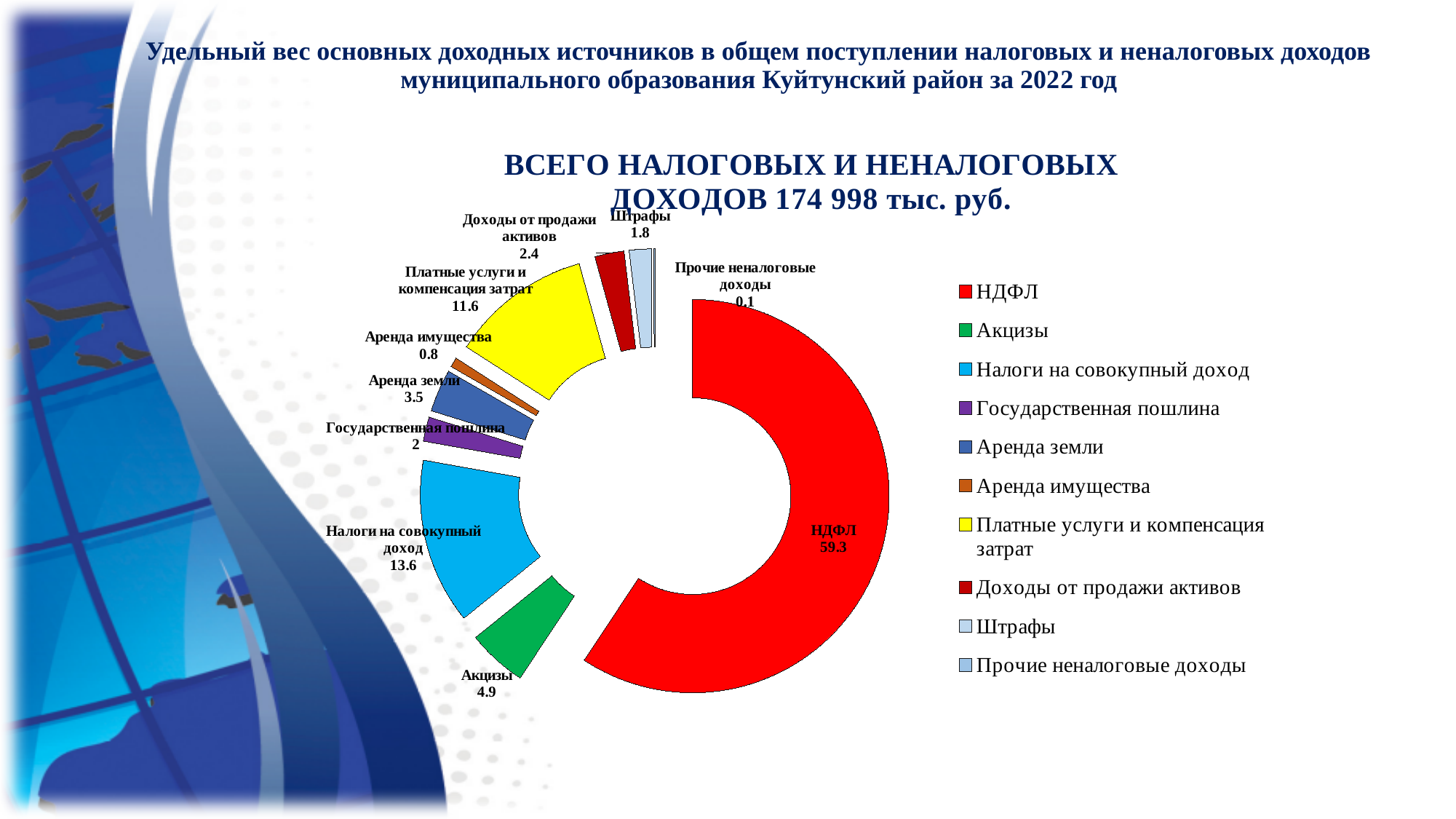
What colour is the segment for Акцизы? Green What total amount of tax and non-tax revenues is stated in the chart title? 174 998 тыс. руб. Which is larger, the value for Акцизы or the value for Аренда земли? Акцизы What is the difference between the values for Налоги на совокупный доход and Платные услуги и компенсация затрат? 2 What is the value shown for Платные услуги и компенсация затрат? 11.6 How many categories does the legend list? 10 What is the value shown for НДФЛ on the chart? 59.3 What kind of chart is shown on the slide? Doughnut (pie) chart What is the value shown for Аренда земли? 3.5 Which category has the smallest share on the chart? Прочие неналоговые доходы Which category has the largest share on the chart? НДФЛ What is the value shown for Налоги на совокупный доход? 13.6